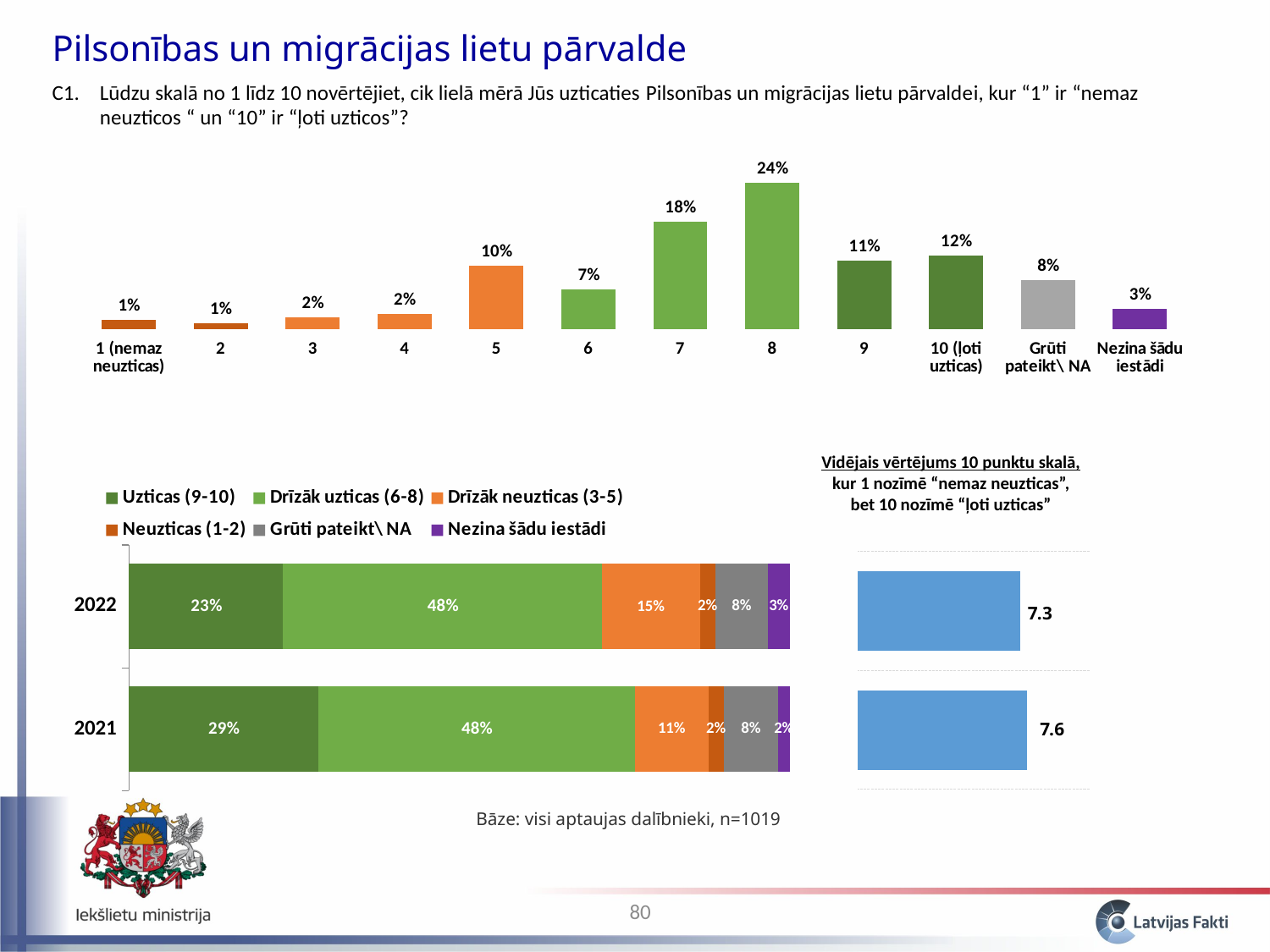
In the top bar chart, which category has the highest value? 8 In the stacked bar chart at the bottom left, what is the value of "Drīzāk neuzticas (3-5)" for 2021? 11% In the top bar chart, what is the value for "Grūti pateikt\ NA"? 8% In the top bar chart, what is the value for category 8? 24% In the top bar chart, what is the difference between the values for category 7 and category 6? 11% In the average rating chart at the bottom right ("Vidējais vērtējums 10 punktu skalā"), what is the value for 2022? 7.3 In the average rating chart at the bottom right, which year has the higher value, 2021 or 2022? 2021 How many categories are shown in the top bar chart? 12 In the stacked bar chart at the bottom left, what is the difference between the "Uzticas (9-10)" values for 2021 and 2022? 6% In the top bar chart, which is larger, the value for category 9 or the value for "10 (ļoti uzticas)"? 10 (ļoti uzticas) In the stacked bar chart at the bottom left, what is the value of "Uzticas (9-10)" for 2022? 23% How many series does the legend of the stacked bar chart at the bottom left list? 6